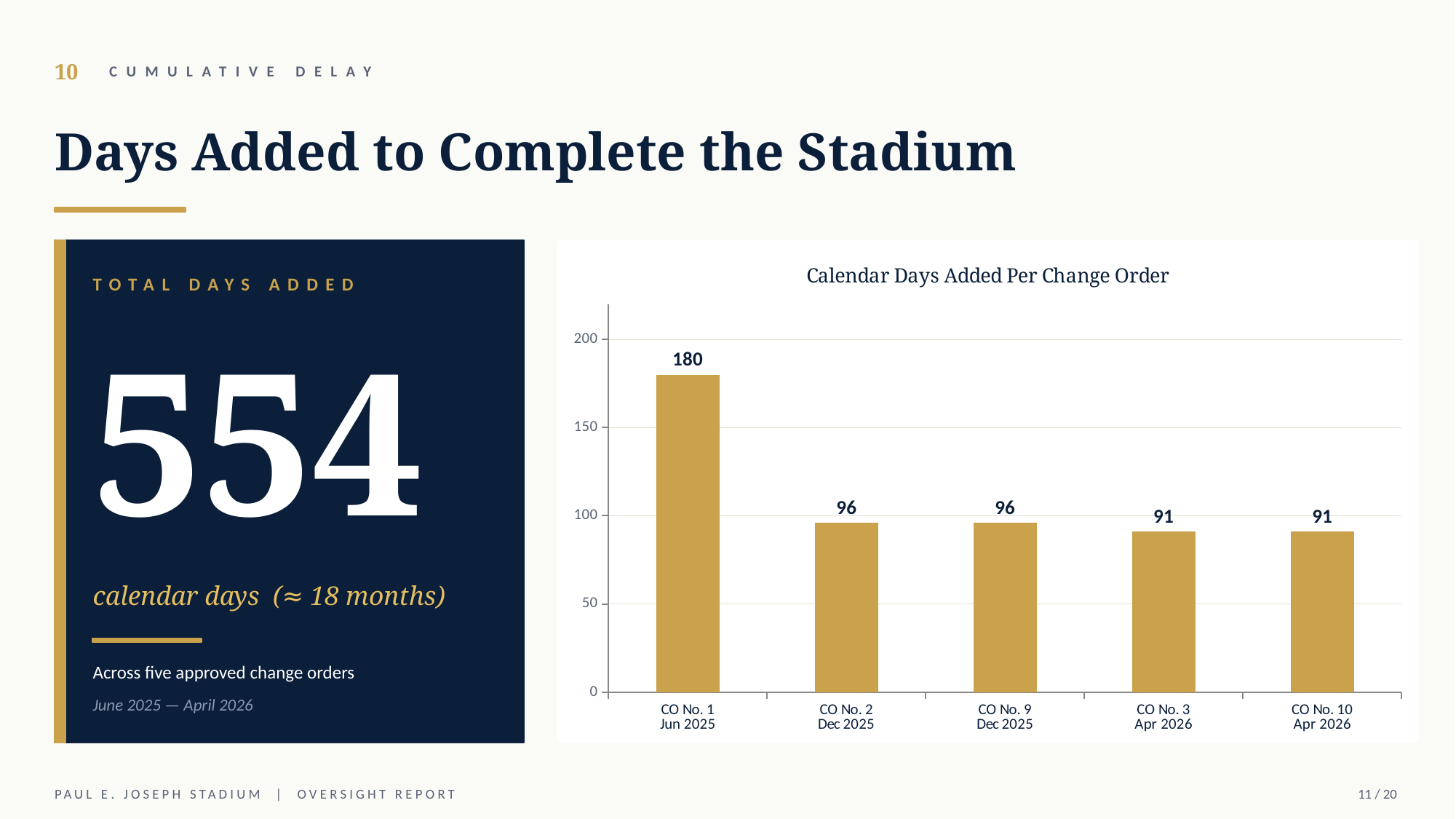
What is the title of the chart? Calendar Days Added Per Change Order What is the difference in days added between CO No. 1 and CO No. 2? 84 Is the value for CO No. 10 greater or less than 100? less What is the value for CO No. 3 (Apr 2026)? 91 What kind of chart is shown on the slide? Bar chart Which has more days added, CO No. 9 or CO No. 3? CO No. 9 Is the value for CO No. 1 greater or less than 150? greater How many change orders are shown in the chart? 5 Which change order has the highest number of calendar days added? CO No. 1 What is the difference in days added between CO No. 2 and CO No. 10? 5 What is the value for CO No. 9 (Dec 2025)? 96 What is the value for CO No. 1 (Jun 2025)? 180